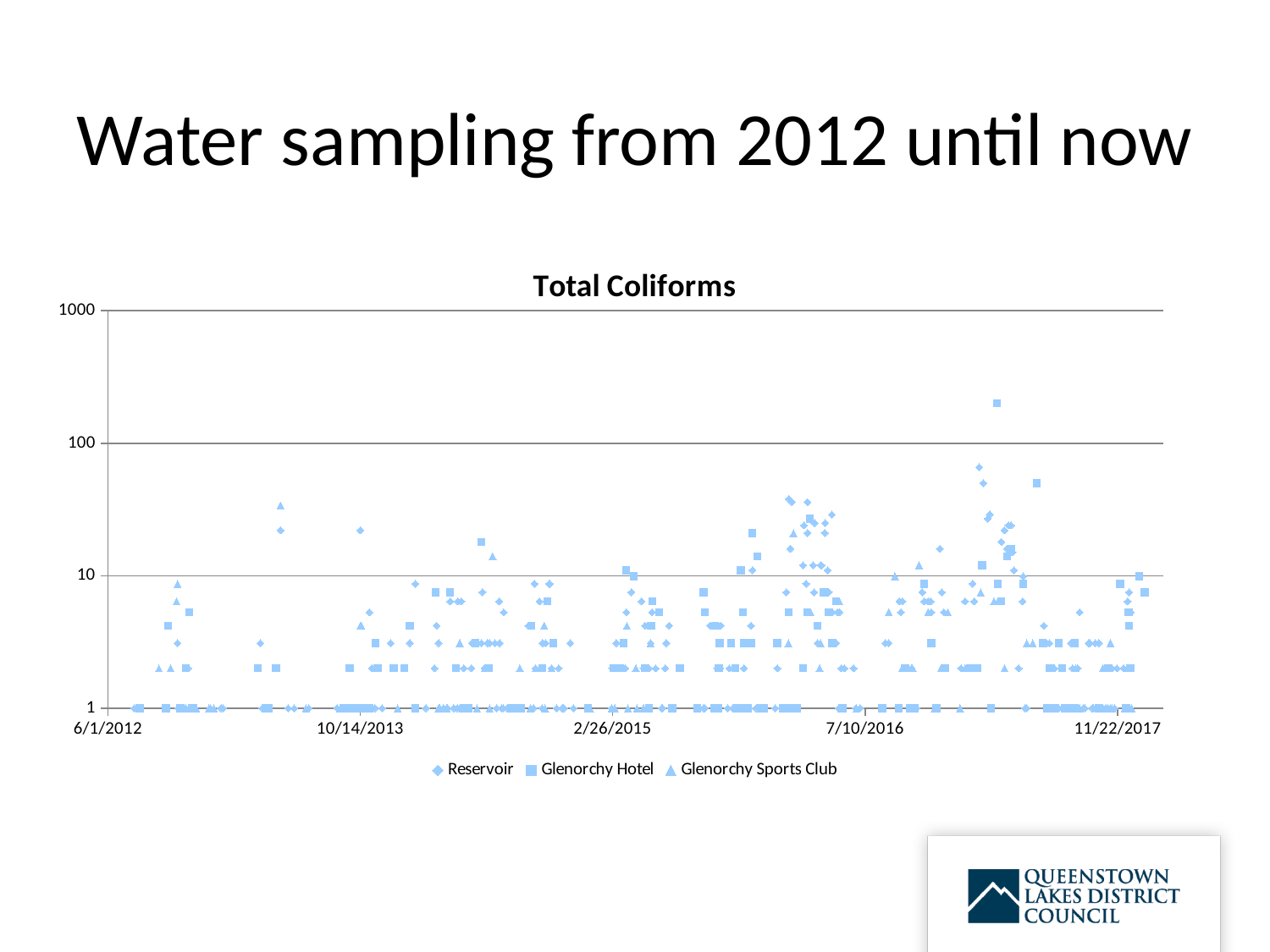
Is the highest value for Reservoir greater or less than 100? less What are the three series named in the legend? Reservoir, Glenorchy Hotel, Glenorchy Sports Club What is the title of the chart? Total Coliforms Is the lowest plotted value on the chart greater or less than 10? less Is the highest plotted value on the chart greater or less than 1000? less What kind of chart is shown on the slide? scatter chart How many date labels are shown along the x axis? 5 How many series does the legend list? 3 Which series has the single highest plotted value? Glenorchy Hotel